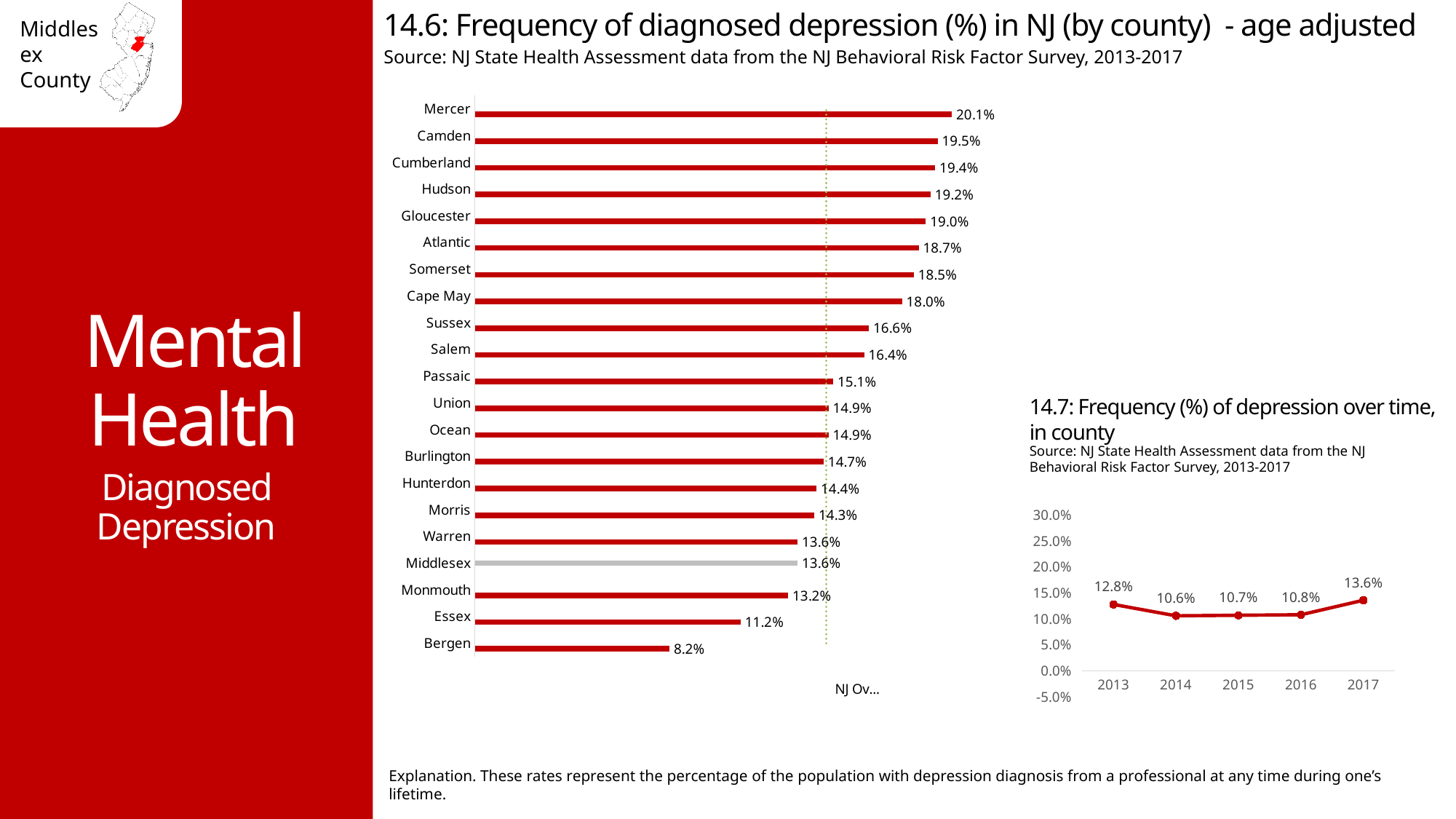
What type of chart is chart 14.6? Bar chart In chart 14.6, what is the value shown for Middlesex county? 13.6% In chart 14.6, what is the frequency of diagnosed depression for Mercer county? 20.1% What type of chart is chart 14.7? Line chart How many counties are shown in chart 14.6? 21 In chart 14.7, what is the frequency of depression in 2017? 13.6% In chart 14.6, which county has the lowest frequency of diagnosed depression? Bergen In chart 14.7, what is the difference between the 2017 and 2013 values? 0.8% In chart 14.6, which county has the highest frequency of diagnosed depression? Mercer In chart 14.6, which county has a higher value, Hudson or Essex? Hudson In chart 14.6, what is the difference between the values for Mercer and Bergen? 11.9% In chart 14.7, which year has the lowest frequency of depression? 2014